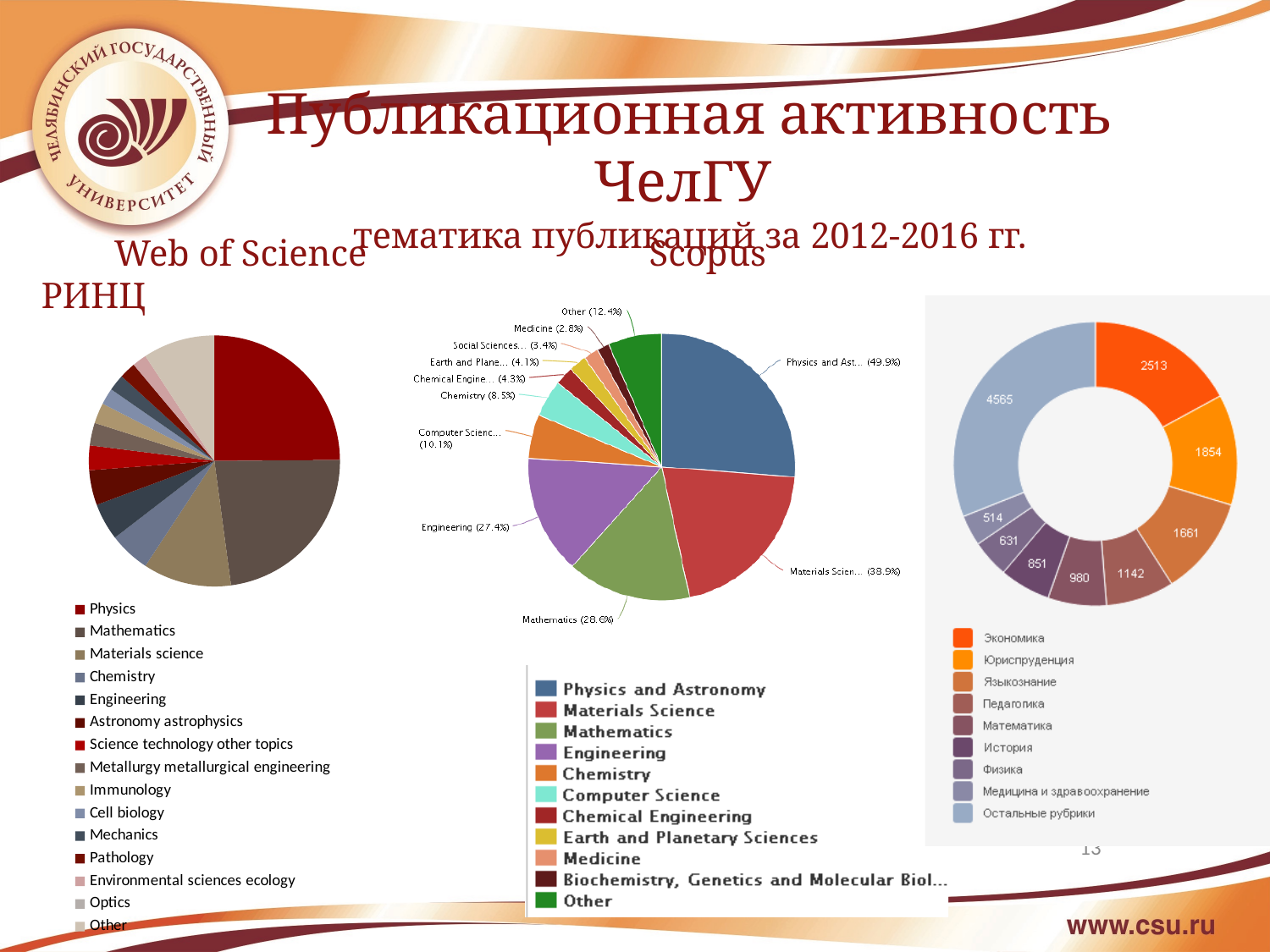
In the РИНЦ chart, what is the value for Экономика? 2513 What kind of chart is the Web of Science chart? Pie chart In the РИНЦ chart, what is the value for Остальные рубрики? 4565 In the Scopus chart, what is the difference between the percentages for Physics and Astronomy and Materials Science? 11.0% How many entries does the legend of the Web of Science chart list? 15 In the Scopus chart, what percentage is shown for Engineering? 27.4% In the РИНЦ chart, which category has the smallest value? Медицина и здравоохранение In the РИНЦ chart, what is the difference between the values for Юриспруденция and Языкознание? 193 In the Scopus chart, which is larger: Computer Science or Chemistry? Computer Science In the Scopus chart, what percentage is shown for Chemistry? 8.5% In the Scopus chart, what percentage is shown for Mathematics? 28.6% In the Scopus chart, which category has the largest percentage? Physics and Astronomy